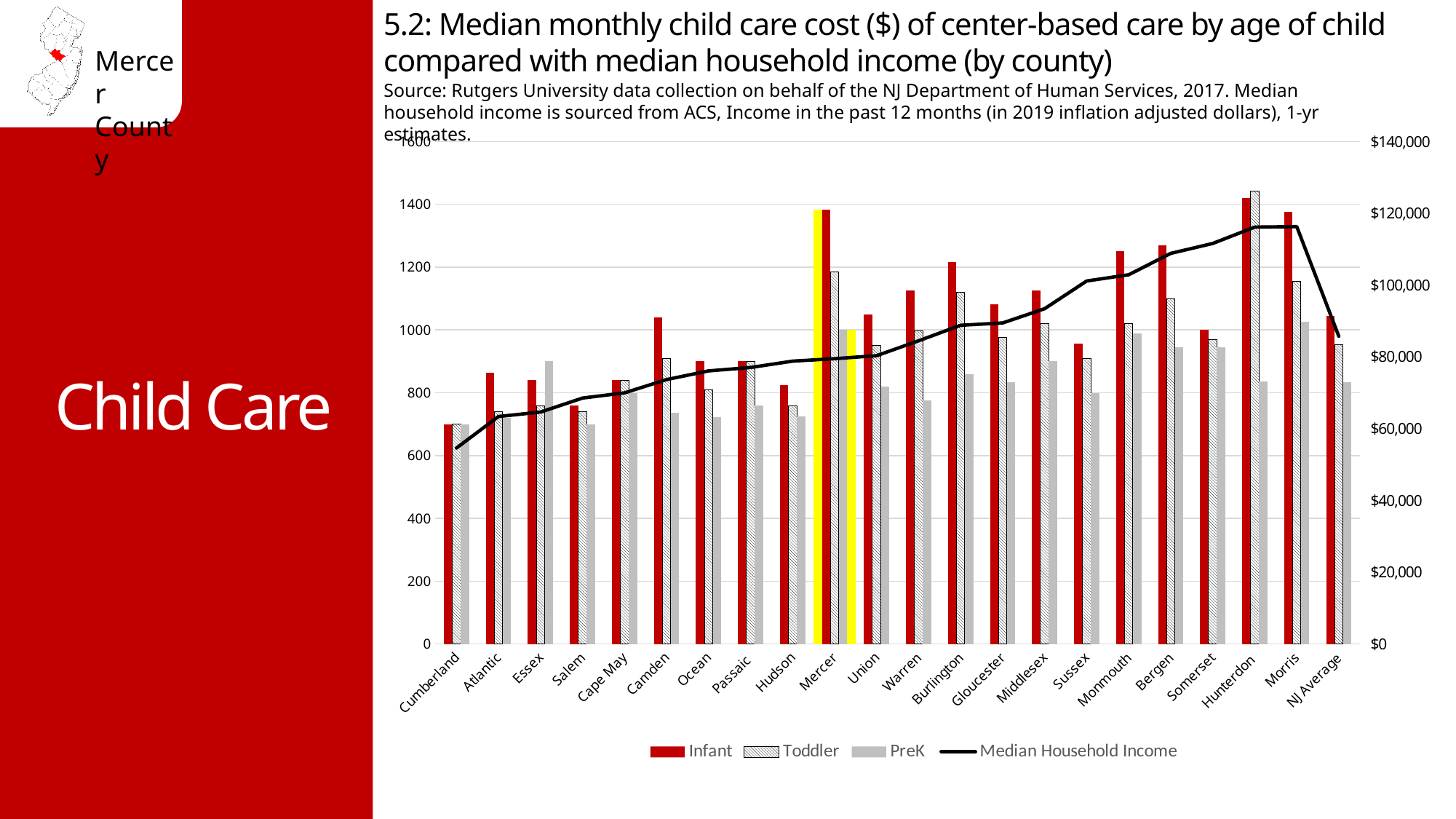
Does the Median Household Income line generally rise or fall from Cumberland to Morris? rise Which county has the highest Toddler bar? Hunterdon Which county has the lowest Infant bar? Cumberland Is the Toddler value for Hunterdon greater or less than 1400? greater Which county's bars are highlighted in yellow? Mercer Is the Infant value for Mercer greater or less than 1200? greater Is the Infant value for Cumberland greater or less than 800? less Which county has the highest Infant bar? Hunterdon Which is larger, the Infant value for Mercer or the Infant value for Union? Mercer How many counties/categories are shown on the x axis? 22 How many series does the legend list? 4 What kind of chart is this? Bar chart with a line series